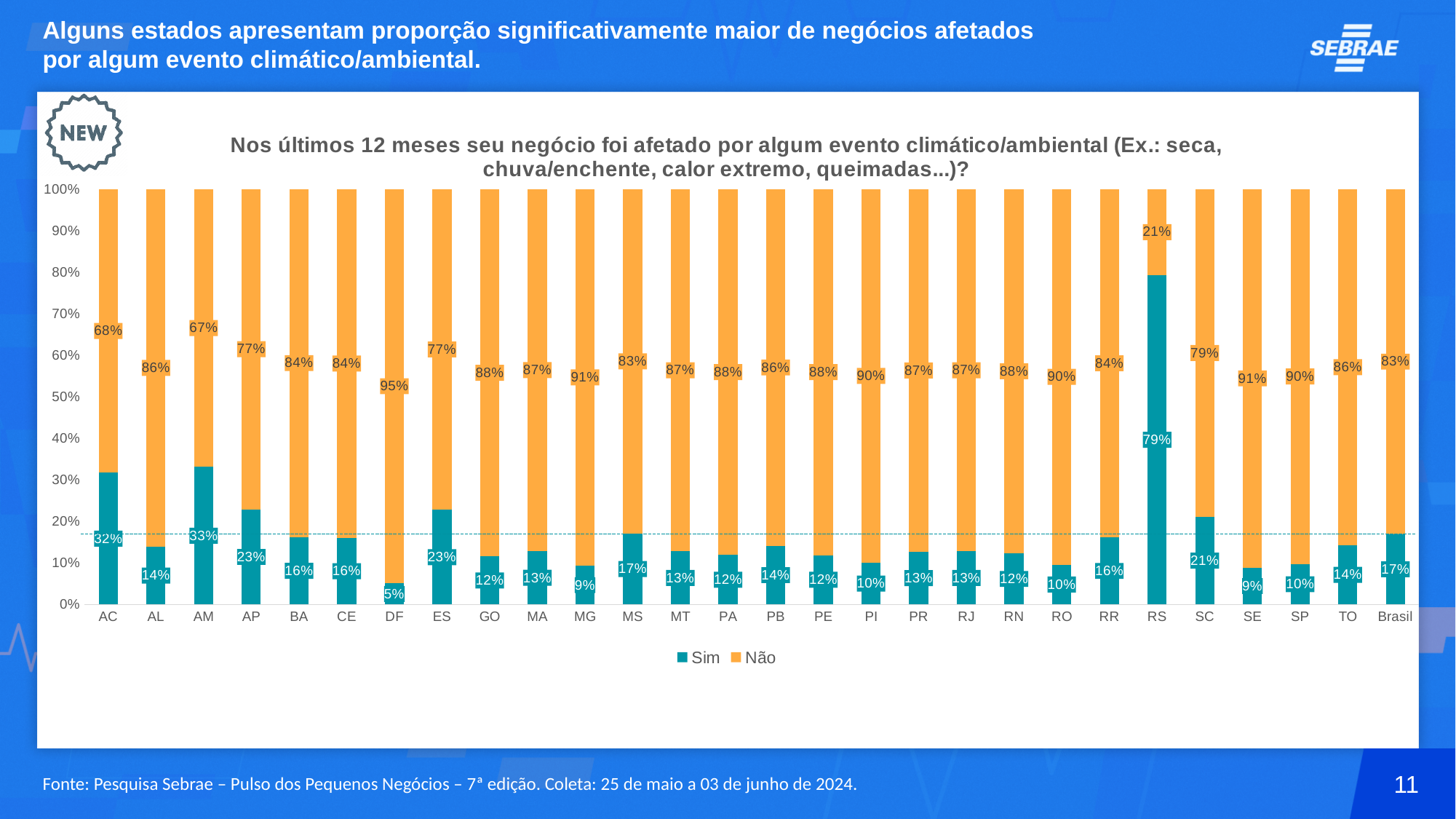
What is the difference in percentage points between the "Sim" value for RS and the "Sim" value for Brasil? 62 percentage points What is the "Sim" value for Brasil? 17% What kind of chart is shown on the slide? Stacked bar chart What percentage of businesses in RS answered "Sim"? 79% What is the "Não" value for DF? 95% Which state has the highest "Sim" share? RS How many series does the legend list? 2 Which state has the lowest "Sim" share? DF What is the total of the stacked bar for AC (Sim plus Não)? 100% Which has a larger "Sim" share, AP or SC? AP Which series is shown in orange in the legend? Não How many categories are shown on the x axis? 28